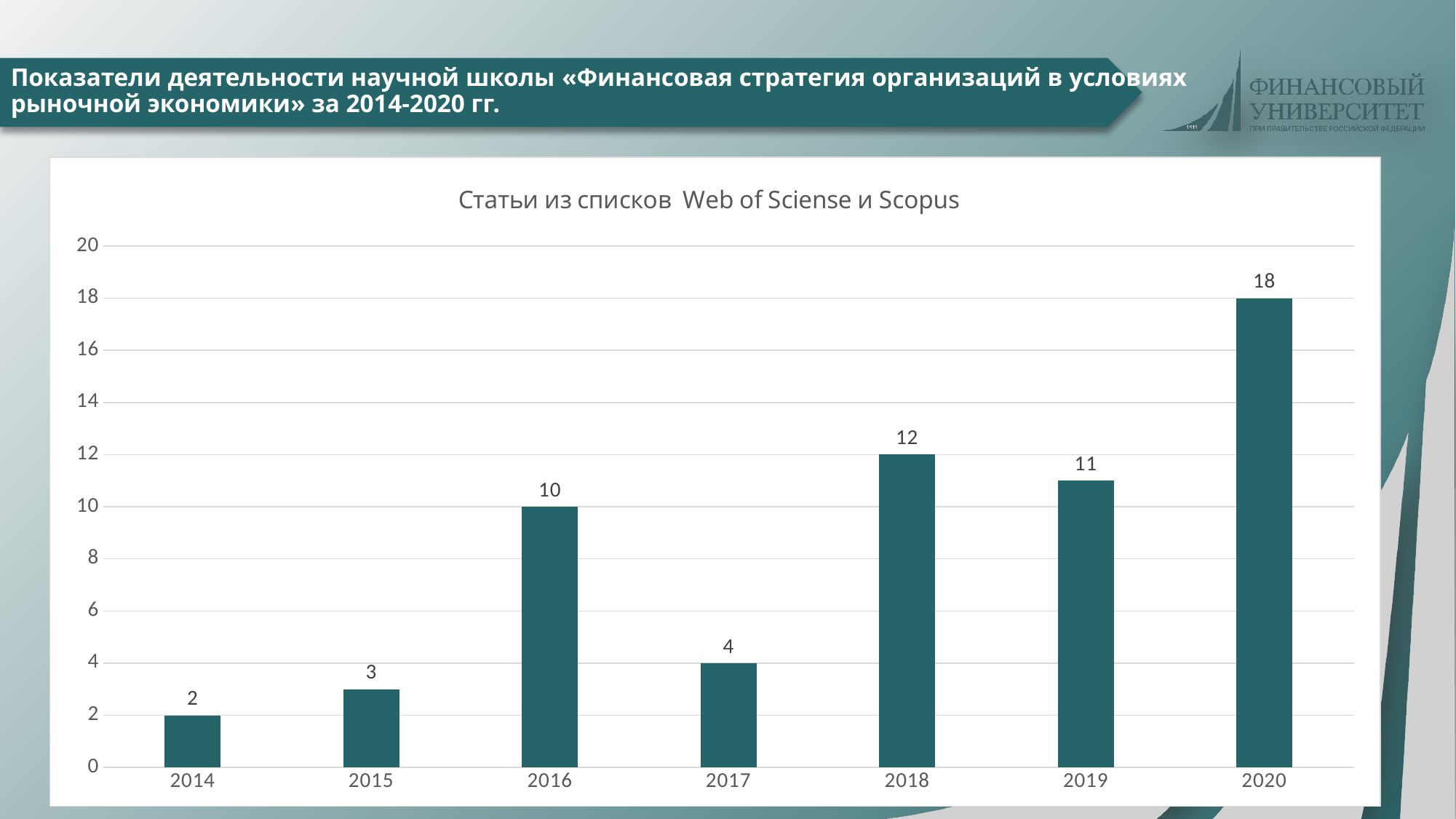
Which year has the highest value? 2020 What kind of chart is shown on the slide? bar chart Is the value for 2018 greater or less than 10? greater What is the title of the chart? Статьи из списков Web of Sciense и Scopus Which year has the lowest value? 2014 Which is larger, the value for 2017 or the value for 2015? 2017 What is the value for 2019? 11 What is the value for 2016? 10 What is the value for 2014? 2 How many years are shown on the x axis? 7 Does the value rise or fall from 2016 to 2017? fall What is the difference between the values for 2020 and 2018? 6